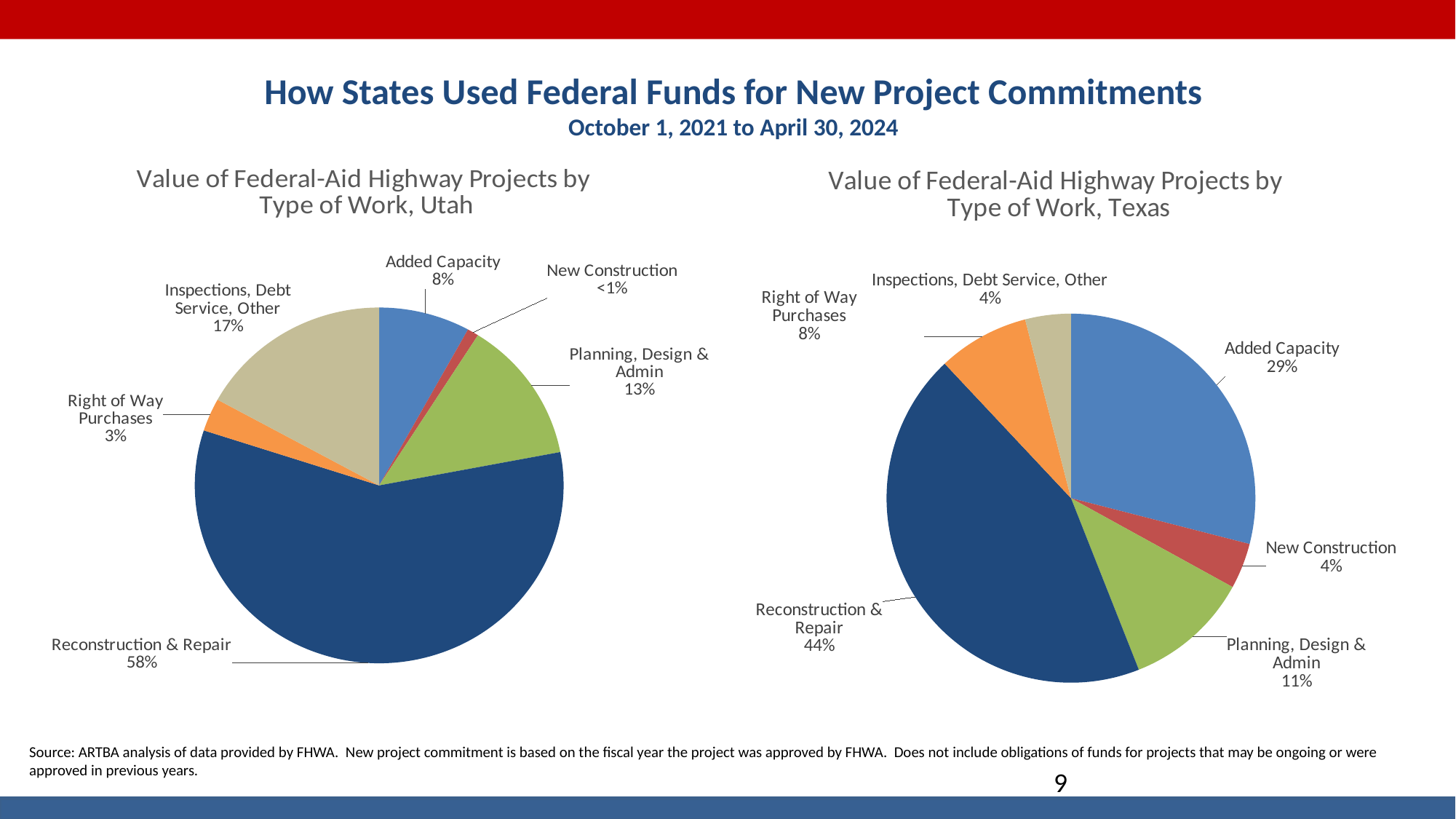
What is the title of the chart on the right side of the slide? Value of Federal-Aid Highway Projects by Type of Work, Texas In the Texas pie chart, what is the difference between the Reconstruction & Repair share and the Added Capacity share? 15% In the Utah pie chart, which type of work has the largest share? Reconstruction & Repair In the Utah pie chart, which type of work has the smallest share? New Construction What kind of chart is used on this slide to show the value of Federal-Aid Highway Projects by type of work? Pie chart In the Texas pie chart, which type of work has the largest share? Reconstruction & Repair Which is larger in the Texas pie chart: Right of Way Purchases or New Construction? Right of Way Purchases In the Texas pie chart, what share is Added Capacity? 29% How many slices does the Utah pie chart have? 6 In the Utah pie chart, what share of the value of Federal-Aid Highway Projects is Reconstruction & Repair? 58% In the Utah pie chart, what is the difference between the Inspections, Debt Service, Other share and the Planning, Design & Admin share? 4% Which chart shows a larger share for Added Capacity, Utah or Texas? Texas